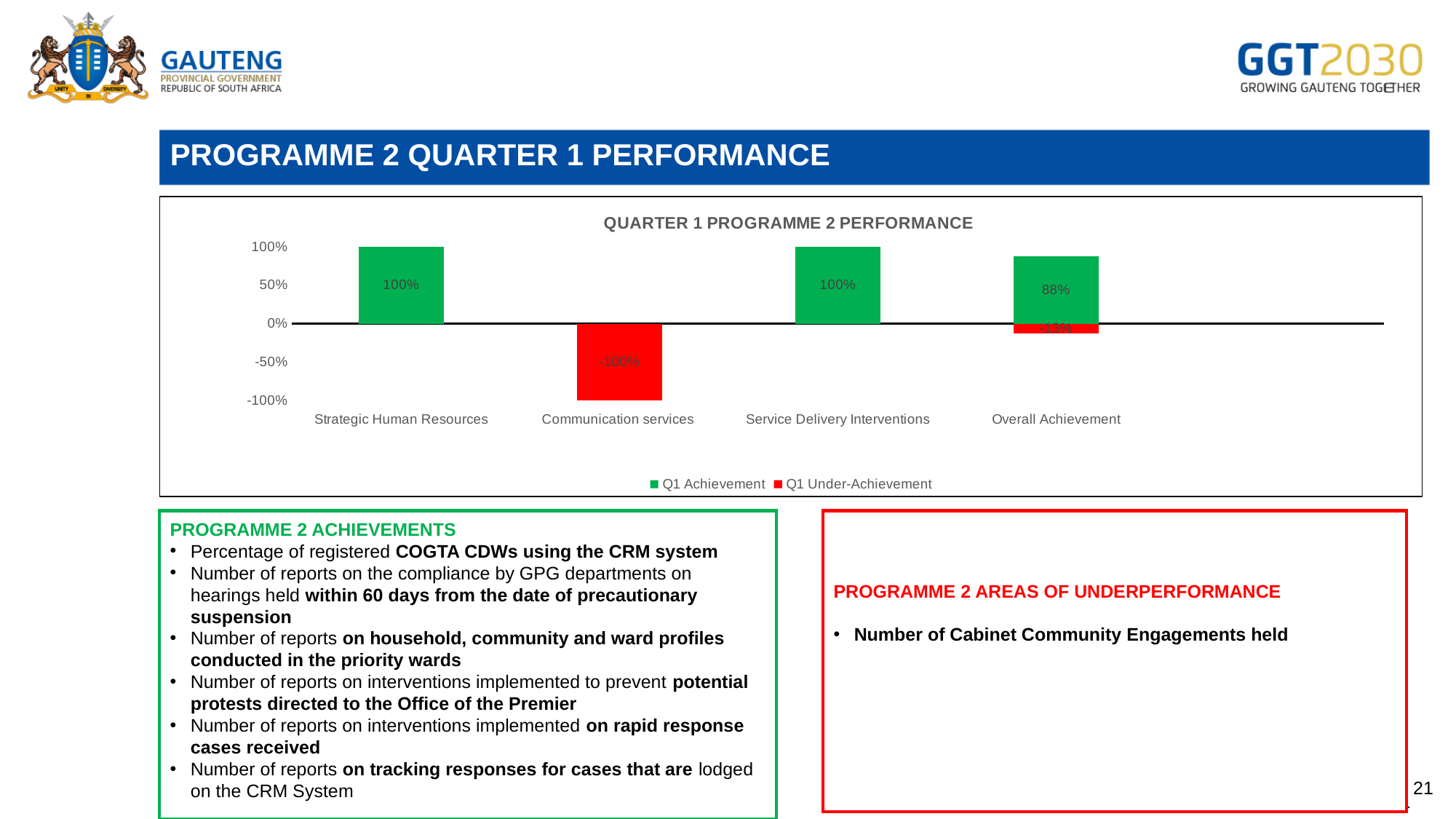
How many categories are shown on the x axis of the chart? 4 What is the Q1 Achievement value for Overall Achievement? 88% What is the title of the chart? QUARTER 1 PROGRAMME 2 PERFORMANCE Which colour represents Q1 Under-Achievement in the chart legend? Red What is the difference between the Q1 Achievement values for Strategic Human Resources and Overall Achievement? 12% What is the Q1 Under-Achievement value for Communication services? -100% What is the Q1 Achievement value for Strategic Human Resources? 100% Which category has the lowest value on the chart? Communication services How many series does the chart legend list? 2 What type of chart is shown on the slide? Bar chart What is the Q1 Achievement value for Service Delivery Interventions? 100% Is the Q1 Achievement value for Overall Achievement greater or less than 50%? greater